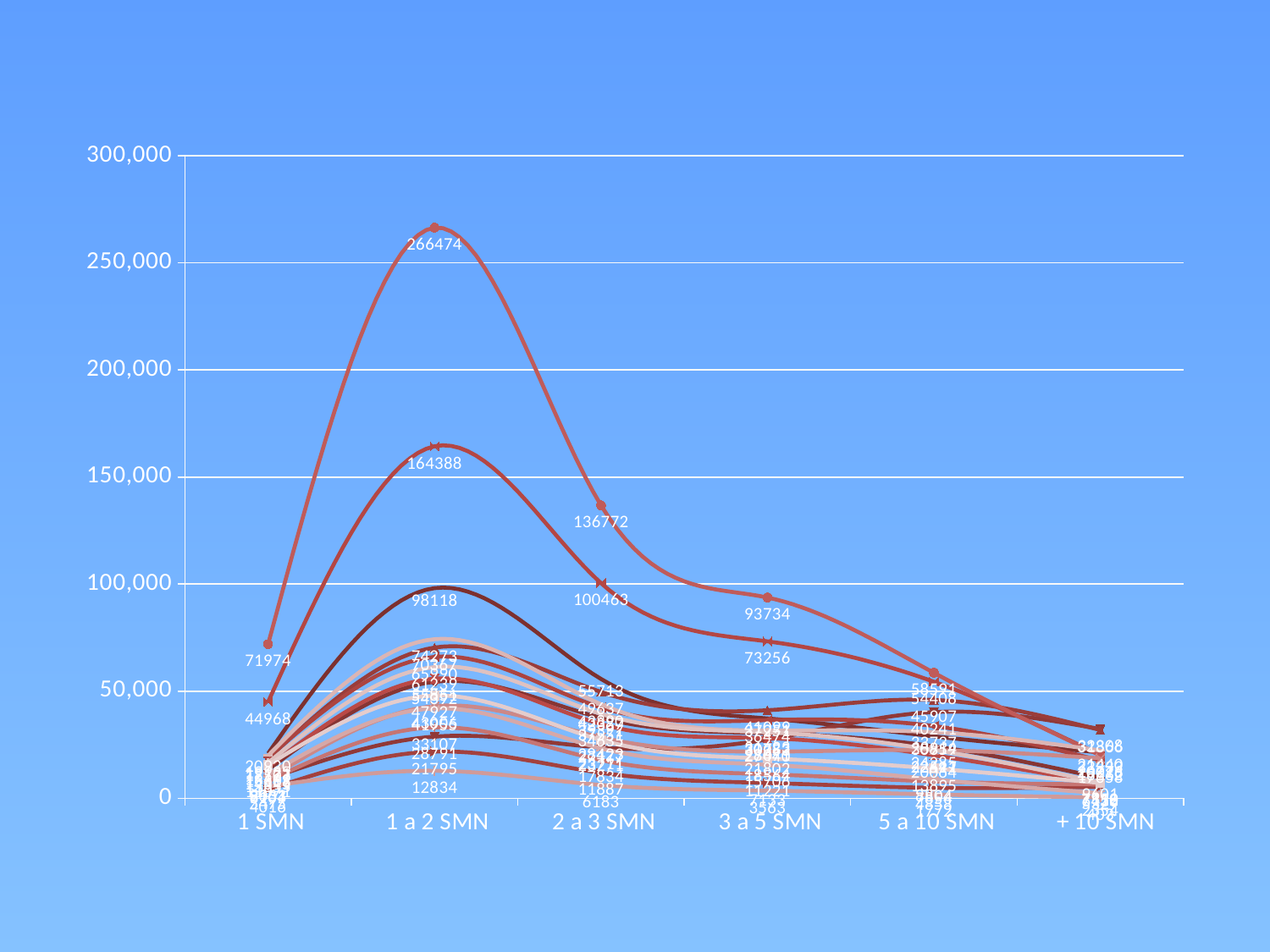
What is the highest data label shown anywhere on the chart? 266474 What is the value of the highest line at 2 a 3 SMN? 136772 How many categories are shown on the x axis? 6 Does the highest line rise or fall from 1 a 2 SMN to + 10 SMN? fall What is the value of the highest line at 1 SMN? 71974 What is the lowest data label shown at 2 a 3 SMN? 6183 What is the value of the highest line at 3 a 5 SMN? 93734 What is the difference between the two highest data labels at 1 a 2 SMN (266474 and 164388)? 102086 What kind of chart is shown on the slide? line chart At which x-axis category does the highest line reach its peak? 1 a 2 SMN What is the second-highest data label at 1 a 2 SMN? 164388 Is the peak value of the highest line at 1 a 2 SMN greater or less than 250,000? greater